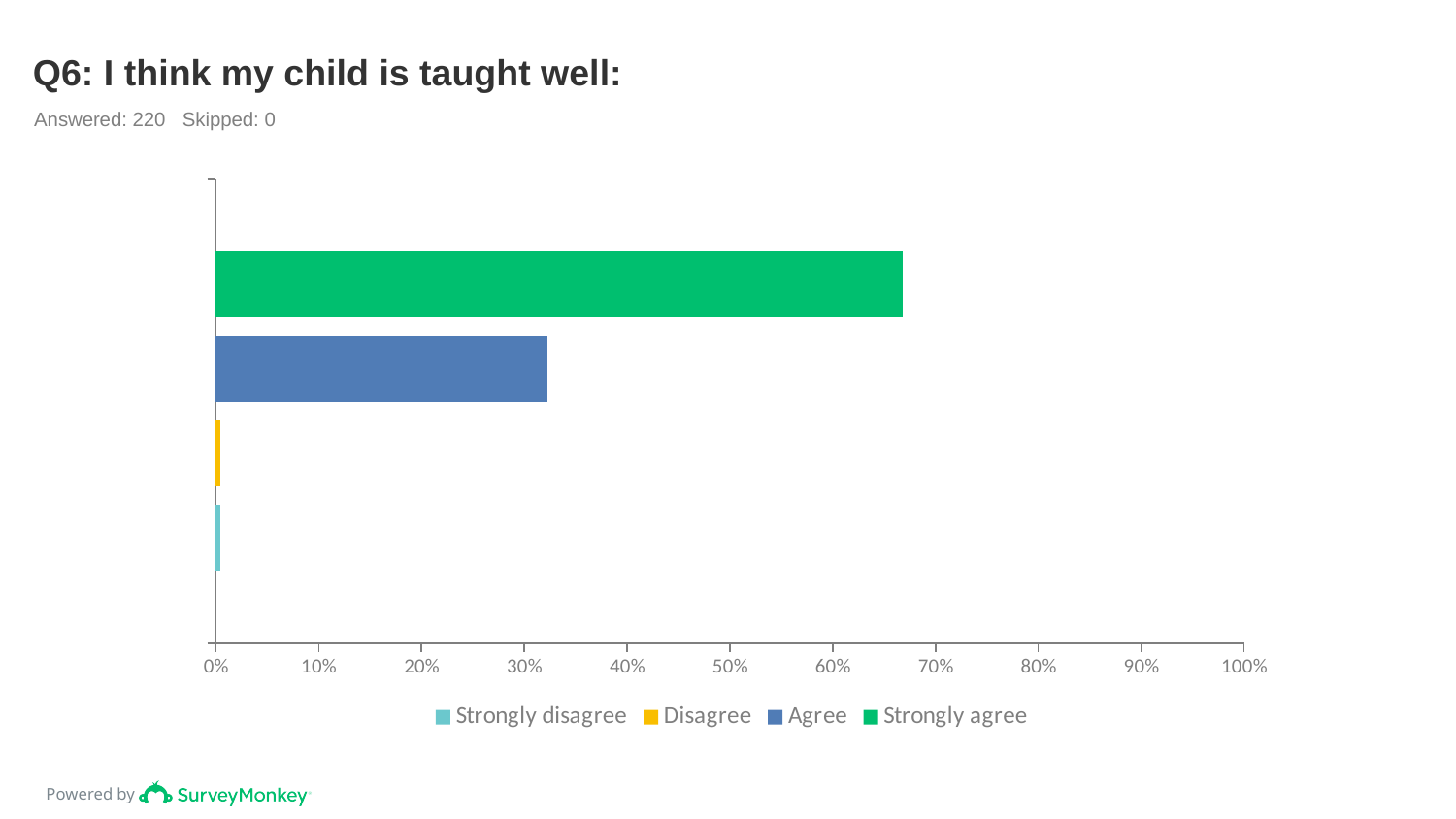
Is the value for Agree greater or less than 30%? greater Which is larger, the value for Strongly agree or the value for Agree? Strongly agree Is the value for Strongly agree greater or less than 70%? less How many series does the legend list? 4 Is the value for Disagree greater or less than 10%? less Which response option has the highest value? Strongly agree How many respondents answered the question according to the slide? 220 What kind of chart is shown on the slide? bar chart What is the title of the chart? Q6: I think my child is taught well: